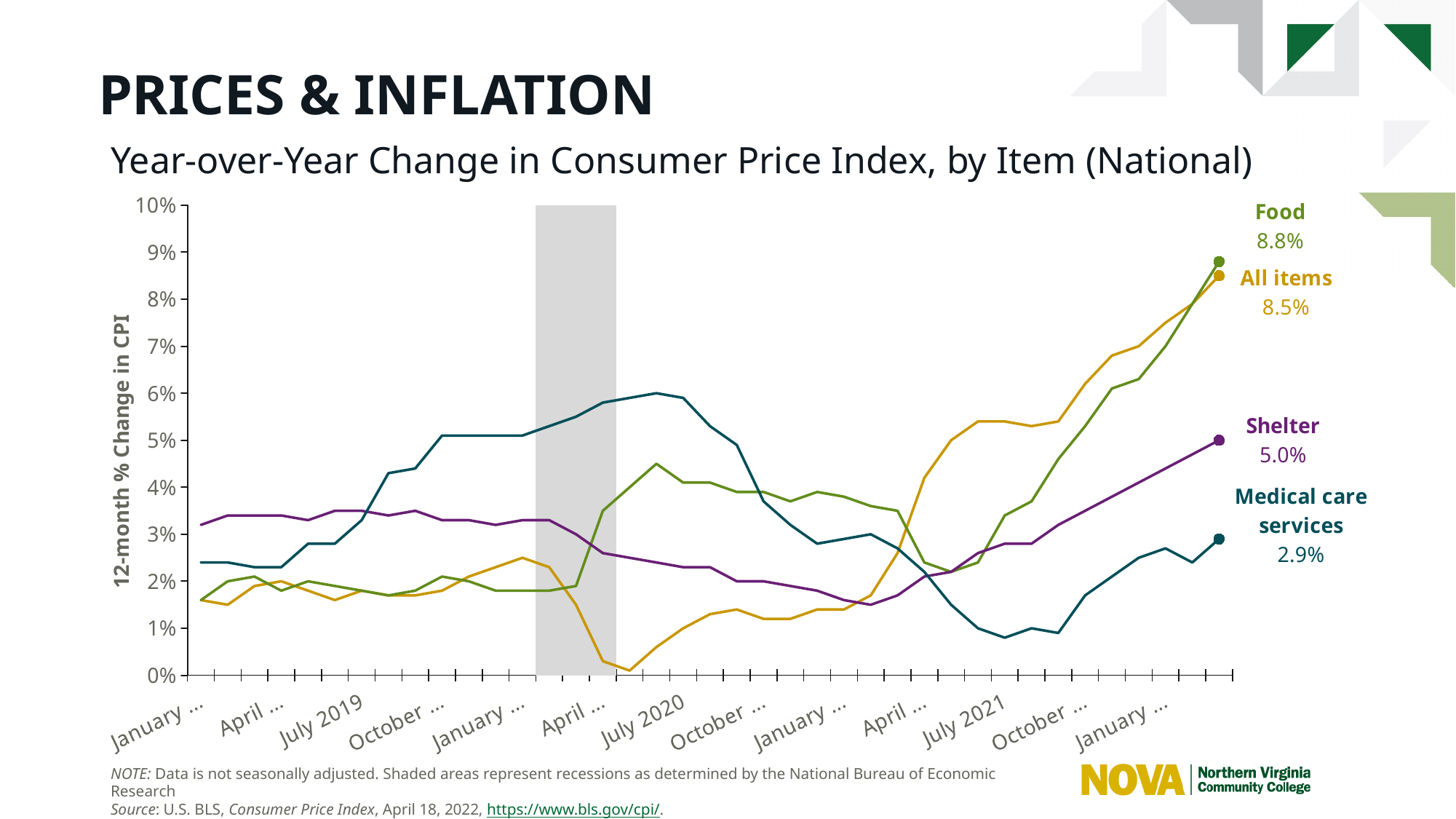
What is the latest value shown for Food? 8.8% What is the difference between the latest Food value and the latest All items value? 0.3 percentage points What is the latest value shown for Shelter? 5.0% Which series has the highest value at the end of the chart? Food At the end of the chart, which is larger: Shelter or Medical care services? Shelter What kind of chart is shown on the slide? Line chart What is the label on the vertical axis of the chart? 12-month % Change in CPI Which series has the lowest value at the end of the chart? Medical care services How many series are plotted on the chart? 4 Is the value for Medical care services in July 2020 greater or less than 5%? greater What is the latest value shown for Medical care services? 2.9% What is the latest value shown for All items? 8.5%